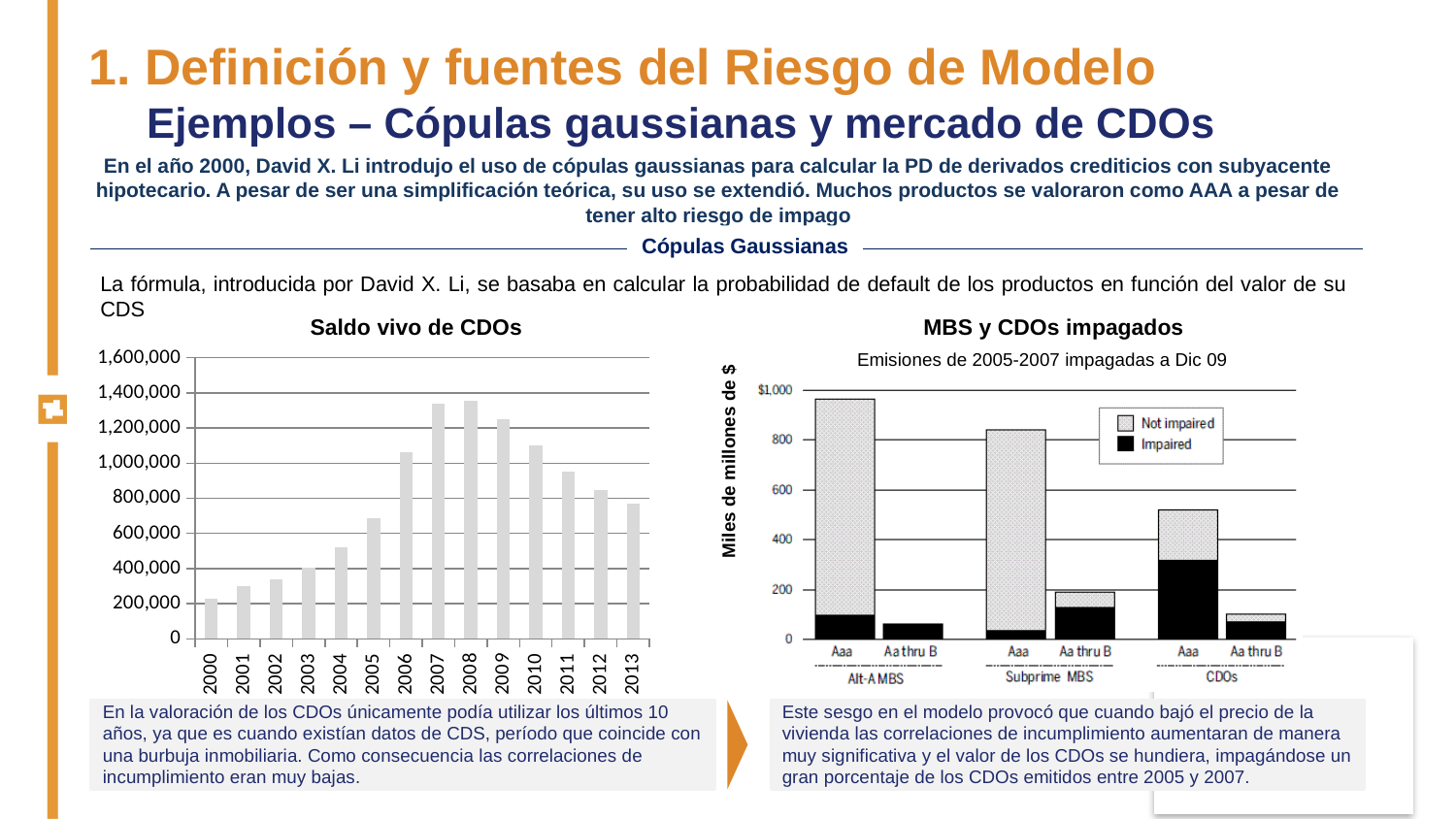
In the 'Saldo vivo de CDOs' chart, is the value for 2006 greater or less than 1,000,000? greater In the 'Saldo vivo de CDOs' chart, which is larger, the value for 2009 or the value for 2011? 2009 How many series does the legend of the 'MBS y CDOs impagados' chart list? 2 In the 'Saldo vivo de CDOs' chart, which year has the lowest value? 2000 How many years are shown on the x axis of the 'Saldo vivo de CDOs' chart? 14 In the 'Saldo vivo de CDOs' chart, is the value for 2005 greater or less than 800,000? less In the 'Saldo vivo de CDOs' chart, do the values rise or fall from 2000 to 2007? rise In the 'Saldo vivo de CDOs' chart, is the value for 2004 greater or less than 400,000? greater What kind of chart is the 'Saldo vivo de CDOs' chart? bar chart In the 'MBS y CDOs impagados' chart, which bar has the largest 'Impaired' segment? CDOs Aaa What is the subtitle shown above the 'MBS y CDOs impagados' chart? Emisiones de 2005-2007 impagadas a Dic 09